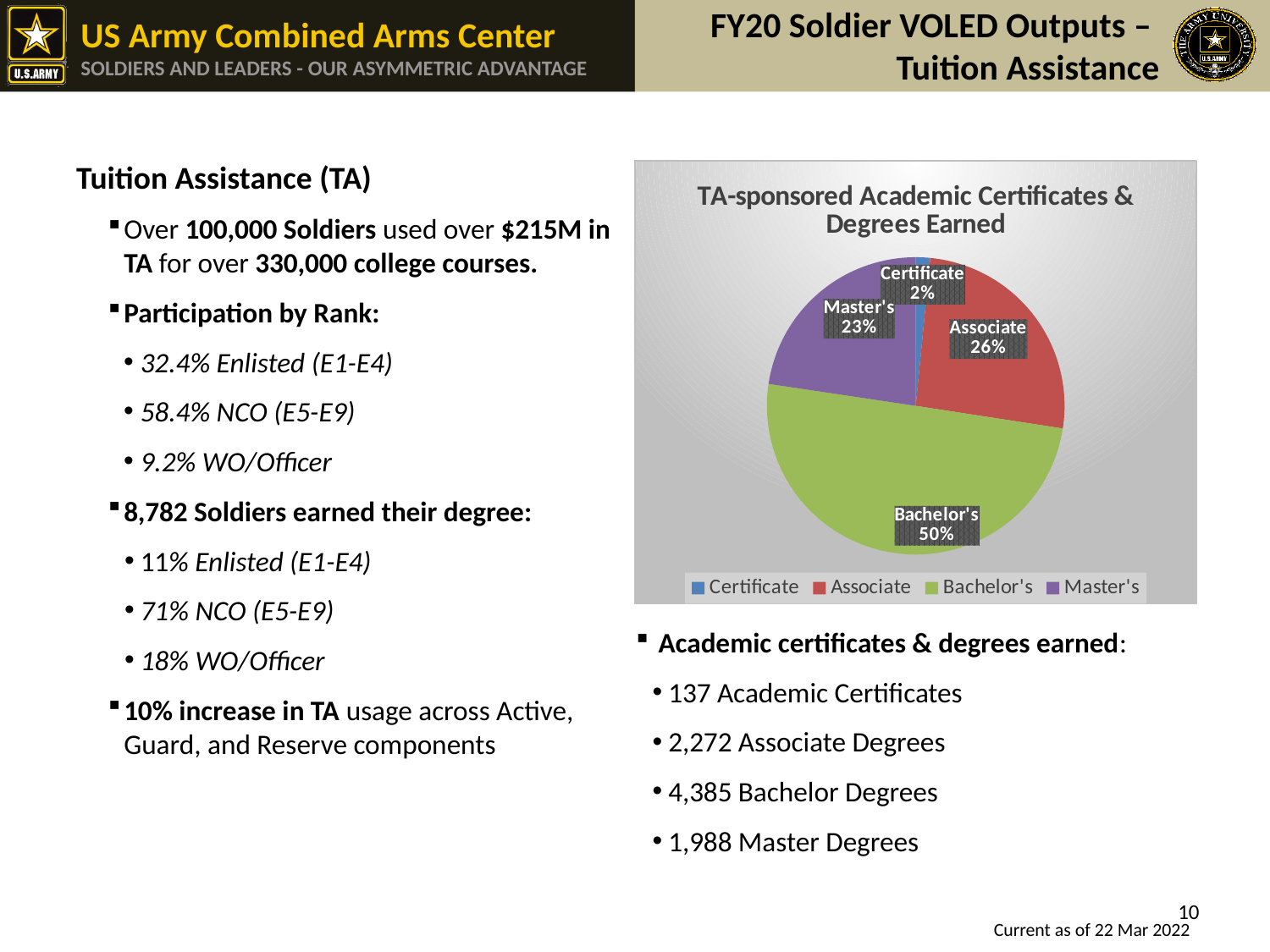
Which category has the largest slice of the pie? Bachelor's Which slice is larger, Associate or Master's? Associate What is the difference in percentage points between the Bachelor's and Associate slices? 24% Which category has the smallest slice of the pie? Certificate How many categories are shown in the pie chart? 4 What share of the pie does Master's represent? 23% What share of the pie does Associate represent? 26% How many entries does the chart legend list? 4 What share of the pie does Bachelor's represent? 50% What kind of chart is shown on the slide? pie chart What is the title of the chart? TA-sponsored Academic Certificates & Degrees Earned